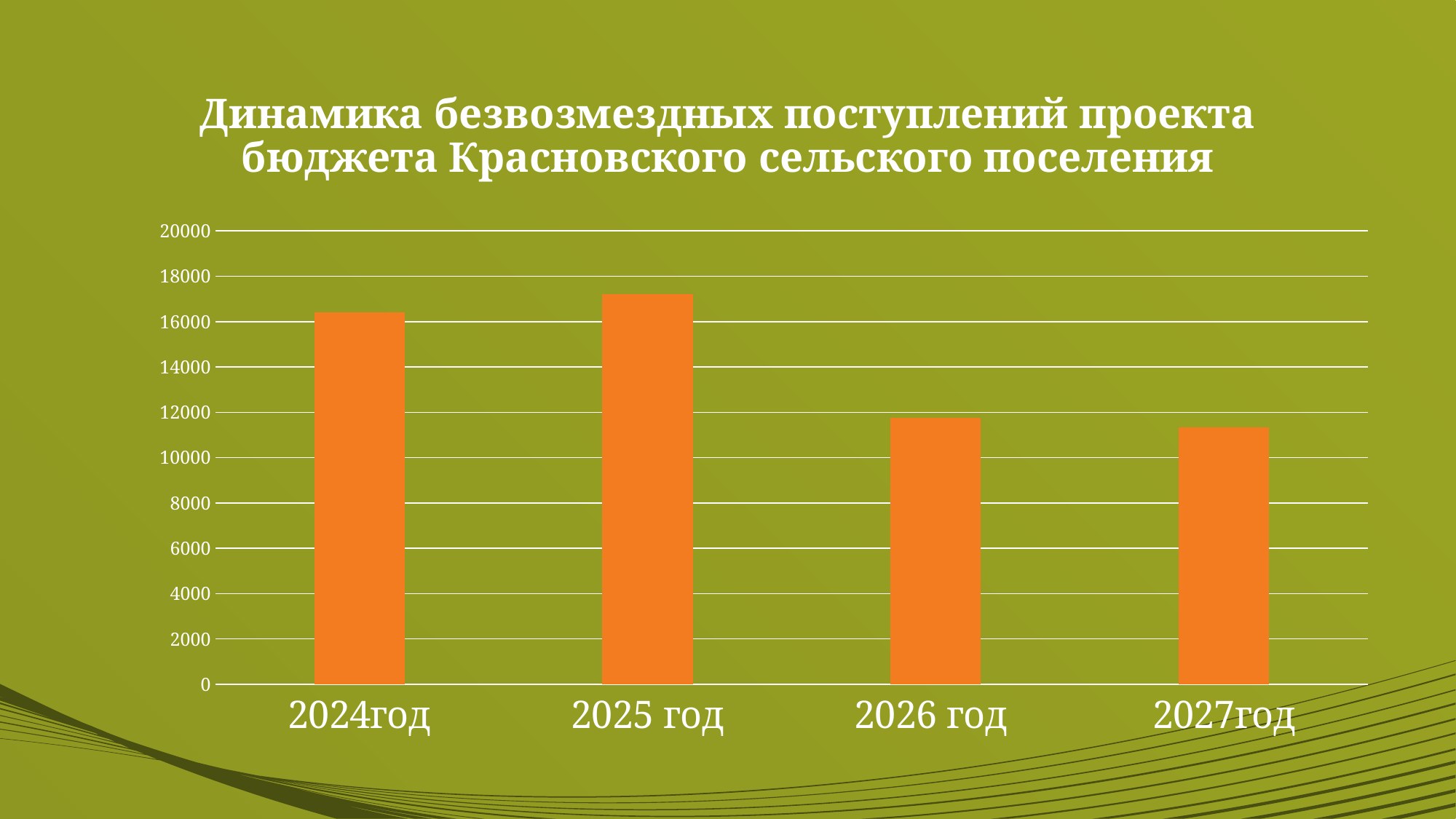
How many years (categories) are shown on the x axis of the chart? 4 Is the value for 2027год greater or less than 10000? greater What colour are the bars in the chart? orange Is the value for 2025 год greater or less than 16000? greater What kind of chart is shown on the slide? bar chart Do the values rise or fall from 2025 год to 2027год? fall Is the value for 2027год greater or less than 12000? less Which is larger, the value for 2025 год or the value for 2026 год? 2025 год Which year has the highest value in the chart? 2025 год Which is larger, the value for 2024год or the value for 2027год? 2024год